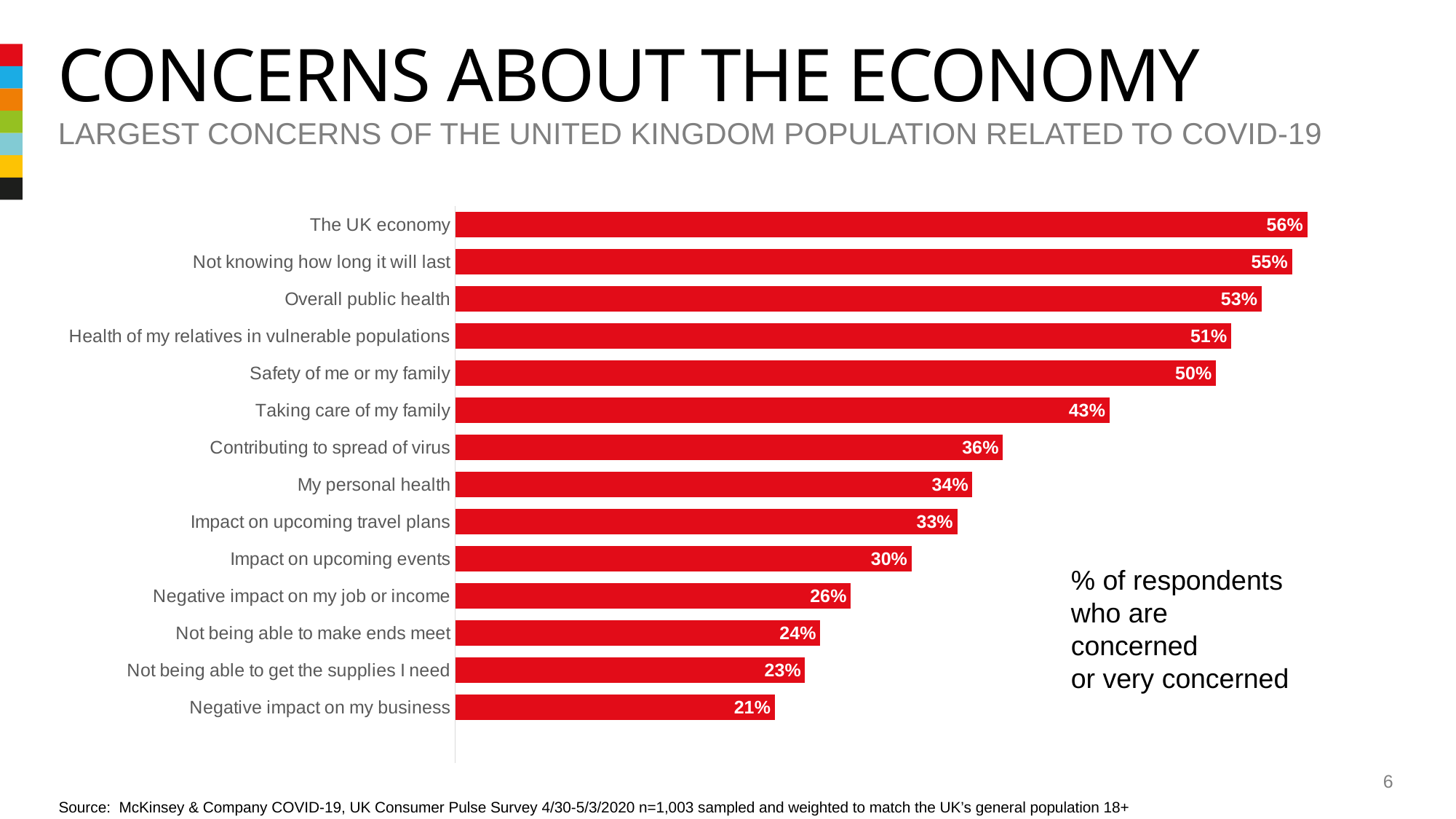
What is the difference between the values for 'Overall public health' and 'My personal health'? 19% What is the value for 'Negative impact on my job or income'? 26% Which is larger: the value for 'Contributing to spread of virus' or the value for 'Impact on upcoming events'? Contributing to spread of virus What is the value for 'Impact on upcoming travel plans'? 33% Which concern has the lowest percentage of respondents? Negative impact on my business What percentage of respondents are concerned or very concerned about the UK economy? 56% What colour are the bars in the chart? Red What kind of chart is shown on the slide? Bar chart What is the value for 'Taking care of my family'? 43% What is the difference between the values for 'Not being able to make ends meet' and 'Not being able to get the supplies I need'? 1% Which concern has the highest percentage of respondents? The UK economy How many concerns are listed in the chart? 14